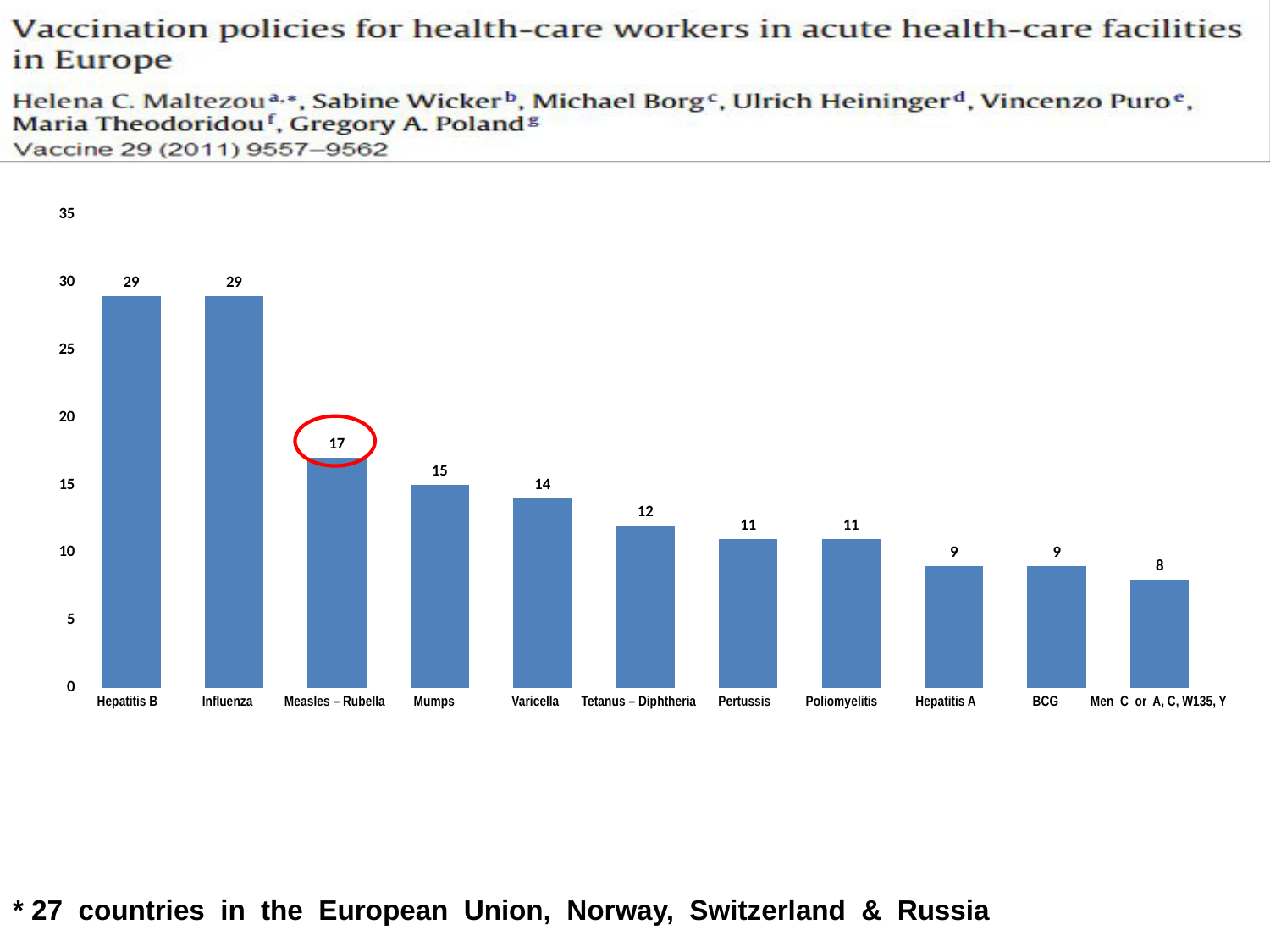
Do the values rise or fall from left to right along the x axis? fall Is the value for Influenza greater or less than 25? greater What is the difference between the values for Measles – Rubella and Hepatitis A? 8 What is the value for Varicella? 14 Which category has the lowest value? Men C or A, C, W135, Y How many categories are shown on the x axis? 11 What kind of chart is shown on the slide? bar chart What is the value for Mumps? 15 Which is larger, the value for Pertussis or the value for BCG? Pertussis What is the difference between the values for Hepatitis B and Mumps? 14 What is the value for Tetanus – Diphtheria? 12 What is the value for Measles – Rubella? 17